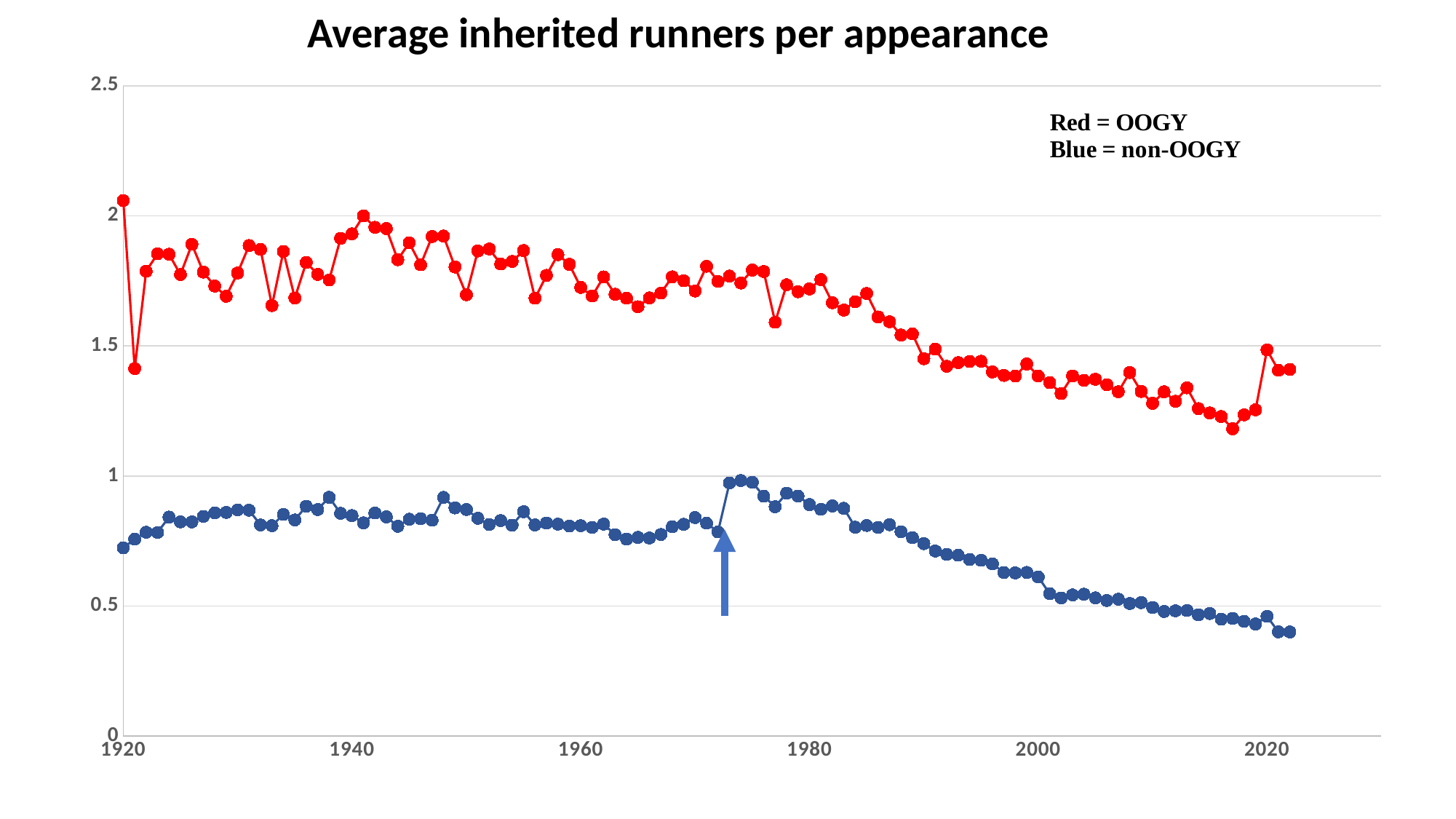
In 1960, which series has the higher value, OOGY or non-OOGY? OOGY Does the non-OOGY (blue) series generally rise or fall between 1990 and 2020? fall Is the non-OOGY (blue) value for 1940 greater or less than 0.5? greater How many series are plotted on the chart? 2 What is the title of the chart? Average inherited runners per appearance Is the non-OOGY (blue) value for 2022 greater or less than 0.5? less Does the OOGY (red) series generally rise or fall between 1980 and 2017? fall Is the OOGY (red) value for 1940 greater or less than 1.5? greater Which colour represents the non-OOGY series? Blue What kind of chart is shown on the slide? line chart